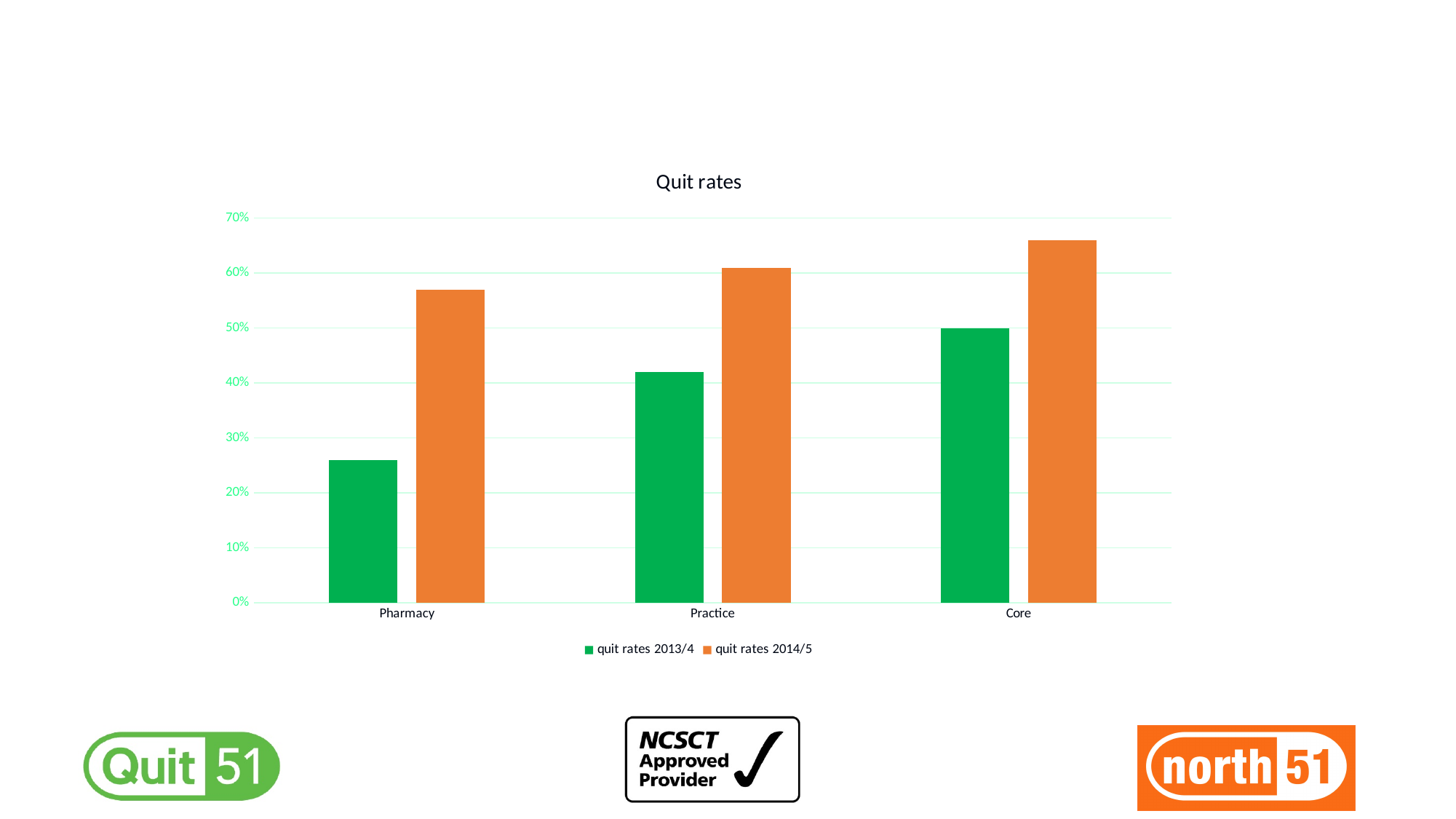
Do the quit rates for 2013/4 rise or fall from Pharmacy to Core along the x axis? rise How many categories are shown on the x axis? 3 How many series does the legend list? 2 What kind of chart is shown on the slide? bar chart Is the quit rate for Pharmacy in 2013/4 greater or less than 30%? less Is the quit rate for Core in 2014/5 greater or less than 70%? less Which is larger for Practice: the quit rate for 2013/4 or for 2014/5? quit rates 2014/5 Which category has the lowest quit rate for 2013/4? Pharmacy What is the title of the chart? Quit rates Which category has the highest quit rate for 2014/5? Core Is the quit rate for Pharmacy in 2014/5 greater or less than 50%? greater